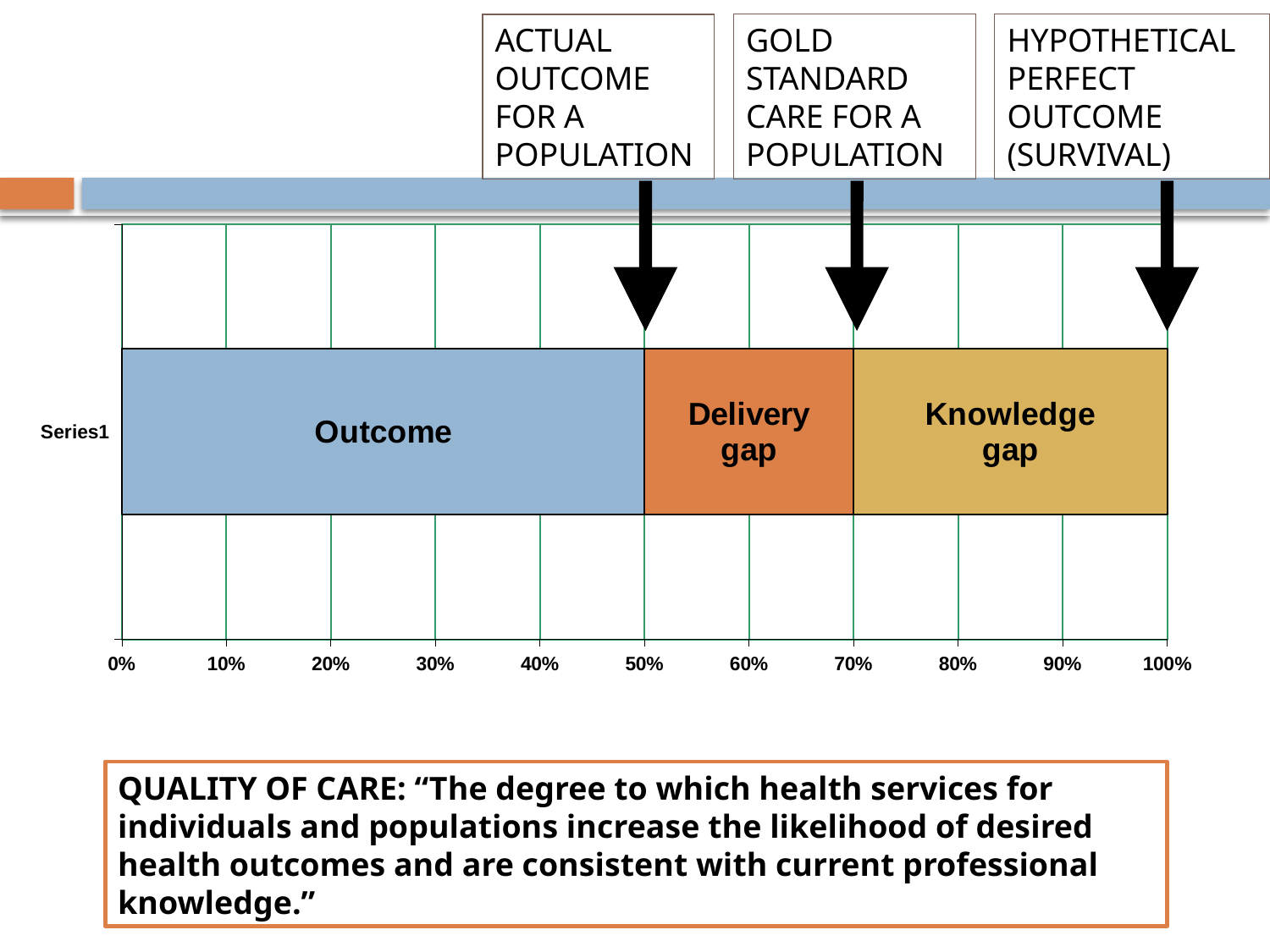
Which segment of the bar is the narrowest? Delivery gap What is the total of the stacked bar? 100% Which segment is wider, Knowledge gap or Delivery gap? Knowledge gap At which axis tick does the Outcome segment end? 50% At which axis tick does the Delivery gap segment end? 70% What is the label of the single category on the vertical axis? Series1 What colour is the Delivery gap segment? Orange Is the width of the Outcome segment greater or less than 40%? greater What kind of chart is shown on the slide? Stacked horizontal bar chart At which axis tick does the Knowledge gap segment end? 100% Which segment of the bar is the widest? Outcome How many segments make up the stacked bar? 3